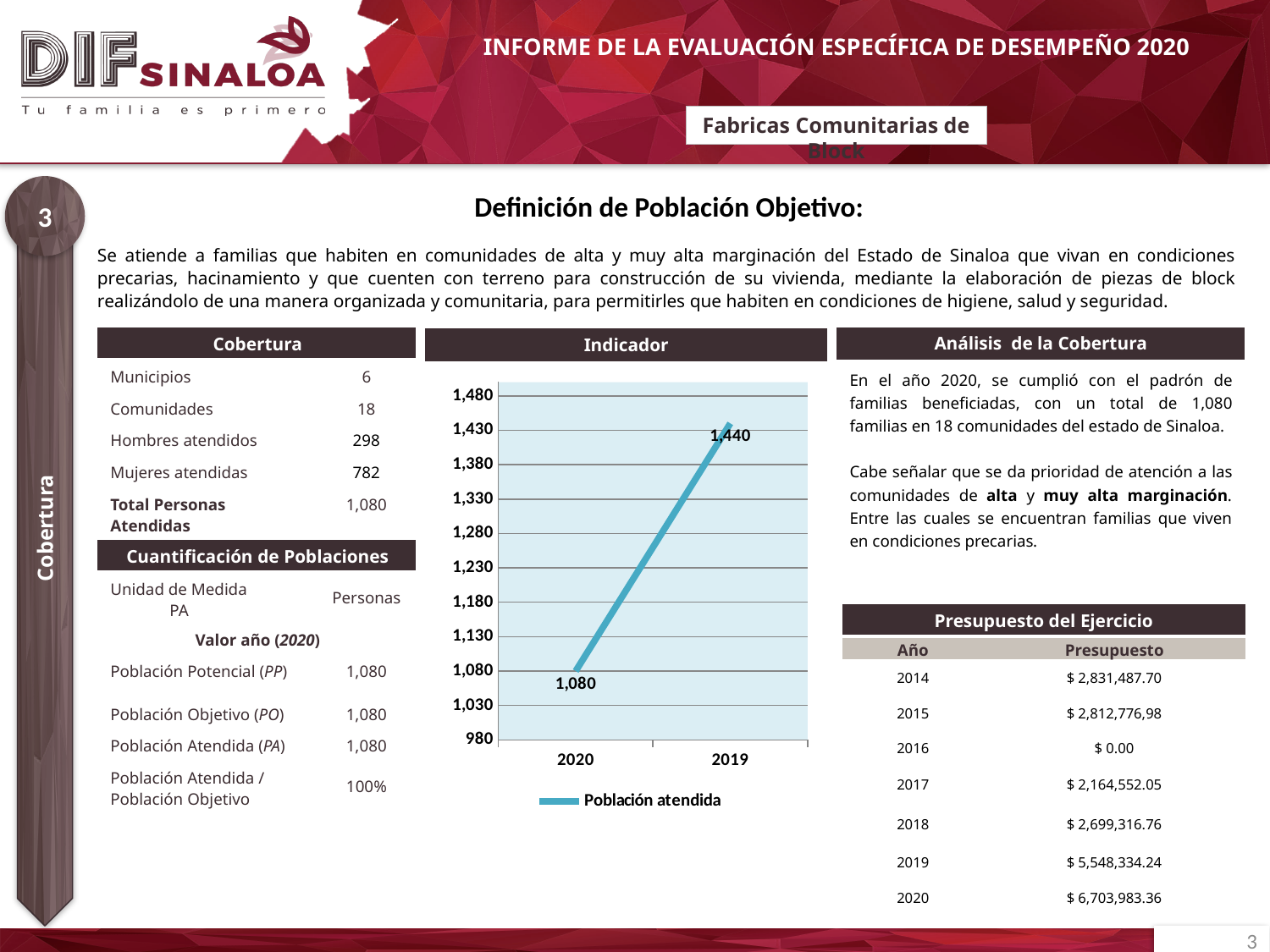
In the Indicador chart, is the value for 2019 greater or less than 1,380? greater What is the name of the series shown in the legend of the Indicador chart? Población atendida In the Indicador chart, which year has the lower value of Población atendida? 2020 In the Indicador chart, what is the difference between the 2019 and 2020 values of Población atendida? 360 In the Indicador chart, is the value for 2019 larger or smaller than the value for 2020? larger What type of chart is shown under the "Indicador" heading? line chart In the Indicador chart, which year has the higher value of Población atendida? 2019 In the Indicador chart, what is the value of Población atendida for 2020? 1,080 How many data points are plotted in the Indicador chart? 2 In the Indicador chart, is the value for 2020 greater or less than 1,230? less In the Indicador chart, what is the value of Población atendida for 2019? 1,440 How many series does the legend of the Indicador chart list? 1